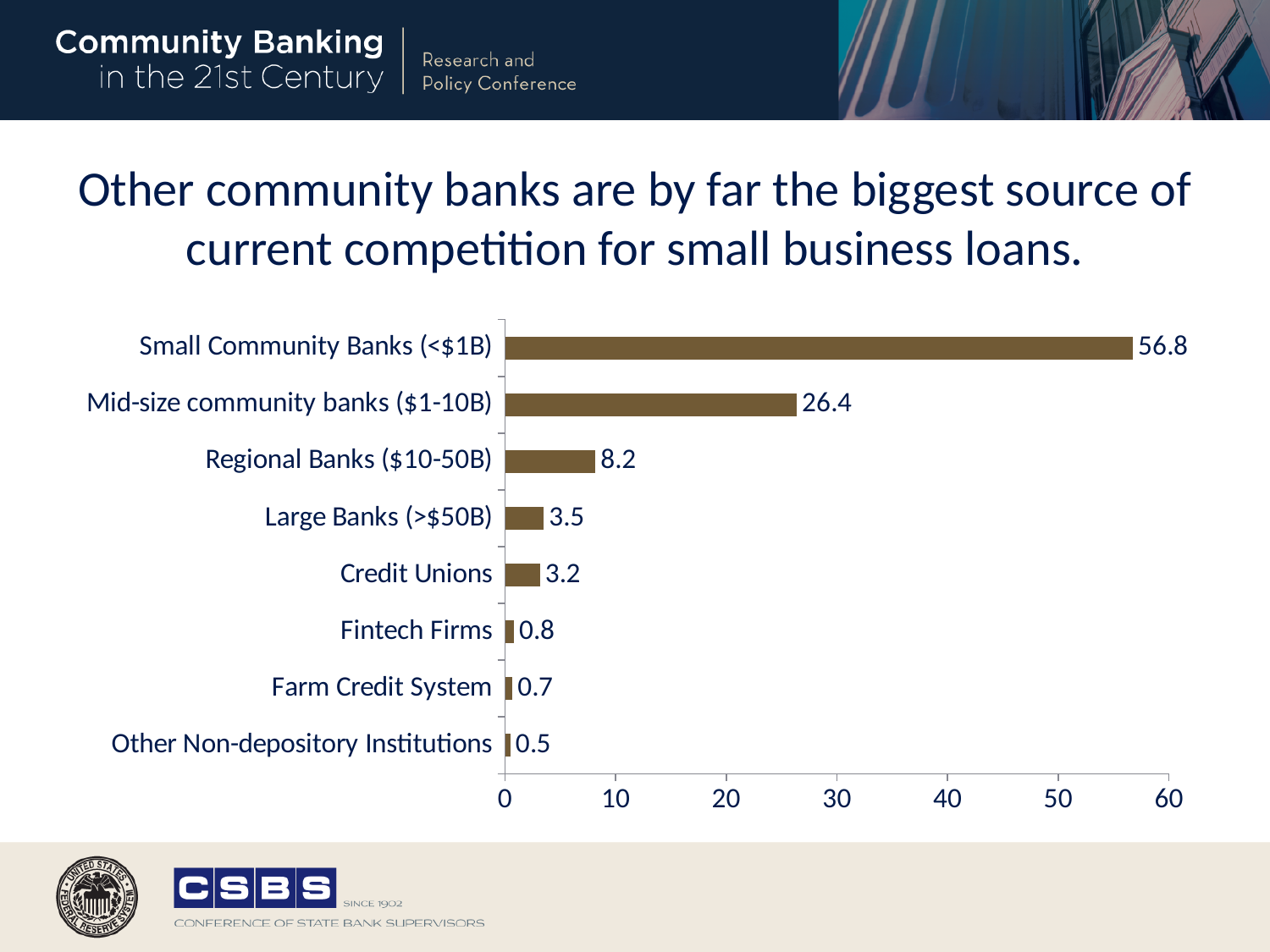
What kind of chart is shown on the slide? bar chart What is the value for Fintech Firms? 0.8 What is the difference between the values for Regional Banks ($10-50B) and Large Banks (>$50B)? 4.7 What is the difference between the values for Small Community Banks (<$1B) and Mid-size community banks ($1-10B)? 30.4 Which is larger, the value for Regional Banks ($10-50B) or the value for Credit Unions? Regional Banks ($10-50B) What is the value for Credit Unions? 3.2 Which category has the lowest value? Other Non-depository Institutions What is the value for Mid-size community banks ($1-10B)? 26.4 How many categories are shown in the chart? 8 Which category has the highest value? Small Community Banks (<$1B) Is the value for Mid-size community banks ($1-10B) greater or less than 30? less What is the value for Small Community Banks (<$1B)? 56.8